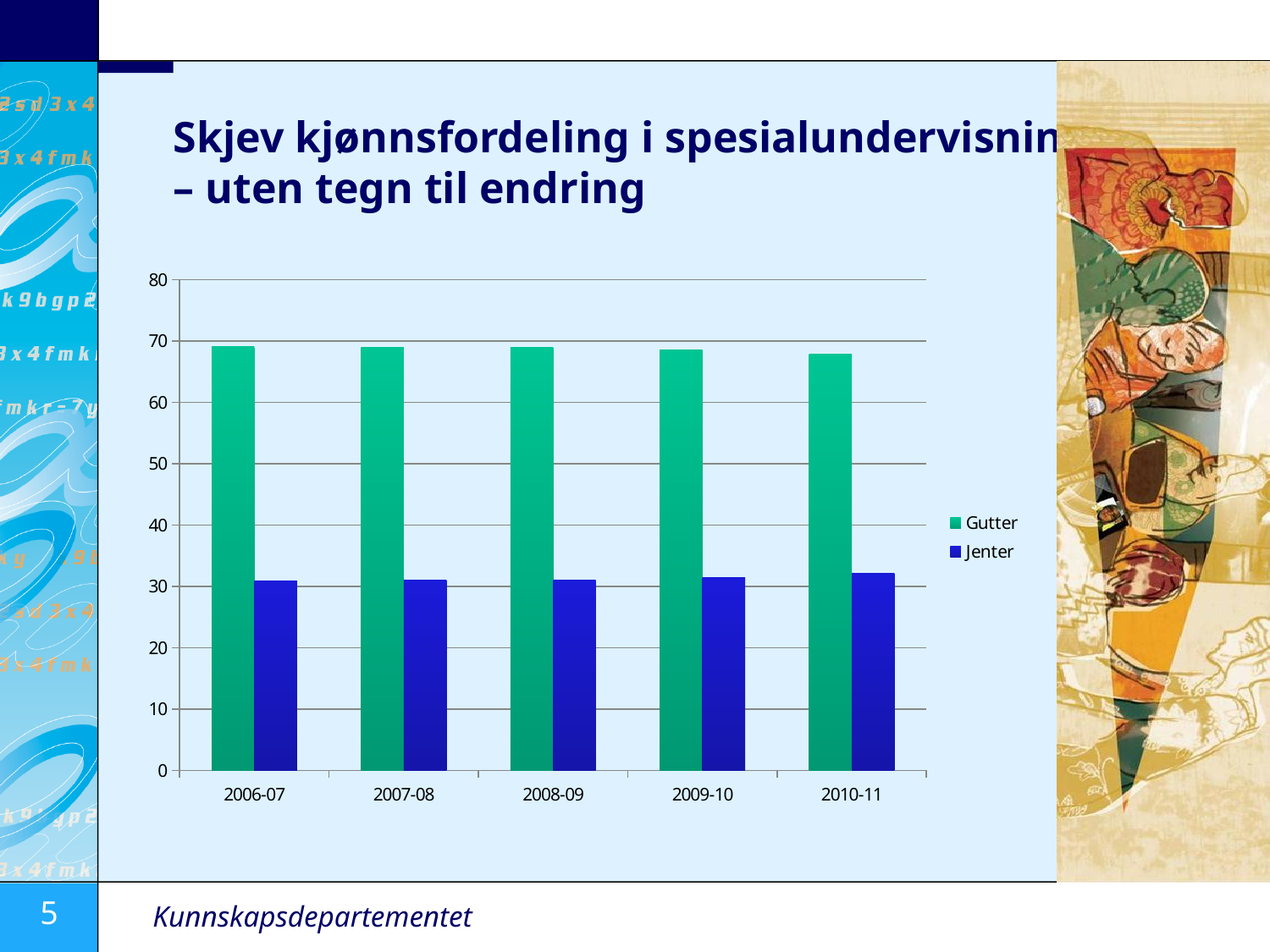
Is the value for Jenter in 2007-08 greater or less than 40? less Which series is larger in 2010-11, Gutter or Jenter? Gutter What kind of chart is shown on the slide? bar chart Is the value for Gutter in 2008-09 greater or less than 70? less Is the value for Gutter in 2009-10 greater or less than 50? greater How many school years are shown on the x axis? 5 What are the two series named in the legend? Gutter and Jenter What colour are the bars for Jenter? blue Which series is larger in 2006-07, Gutter or Jenter? Gutter How many series does the legend list? 2